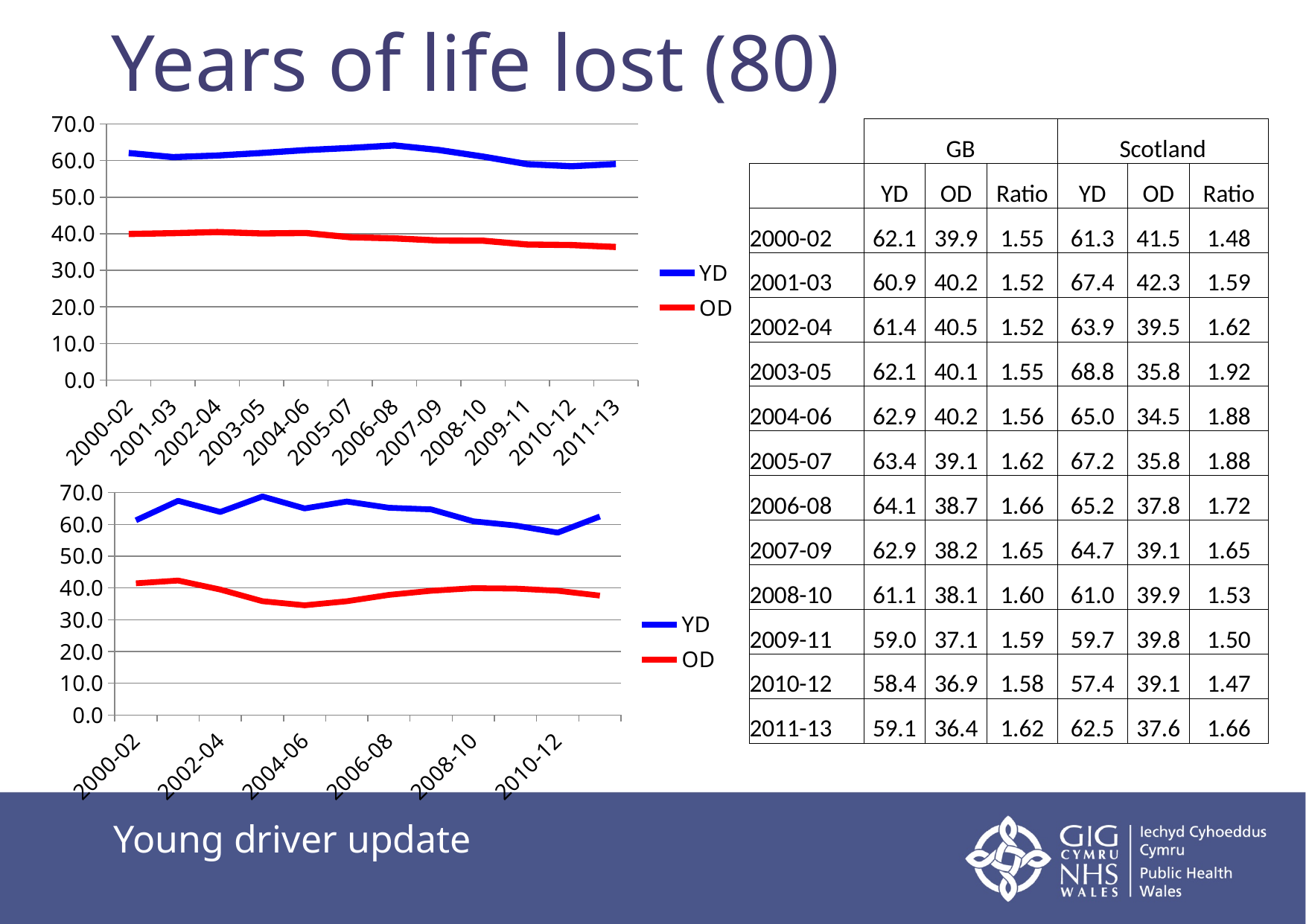
In the bottom chart, is the YD value for 2000-02 greater or less than 50? greater In the top chart, is the OD value for 2011-13 greater or less than 30? greater In the top chart, which colour is used for the OD series? red How many series does the legend of the bottom chart list? 2 In the bottom chart, is the OD value for 2004-06 greater or less than 40? less In the bottom chart, which series has the larger value in 2010-12, YD or OD? YD In the top chart, does the OD series generally rise or fall from 2000-02 to 2011-13? fall In the top chart, which series has the larger value in 2004-06, YD or OD? YD How many time periods are plotted along the x axis of the top chart? 12 What kind of chart is the top chart on the slide? line chart In the bottom chart, in which period is the YD series at its lowest? 2010-12